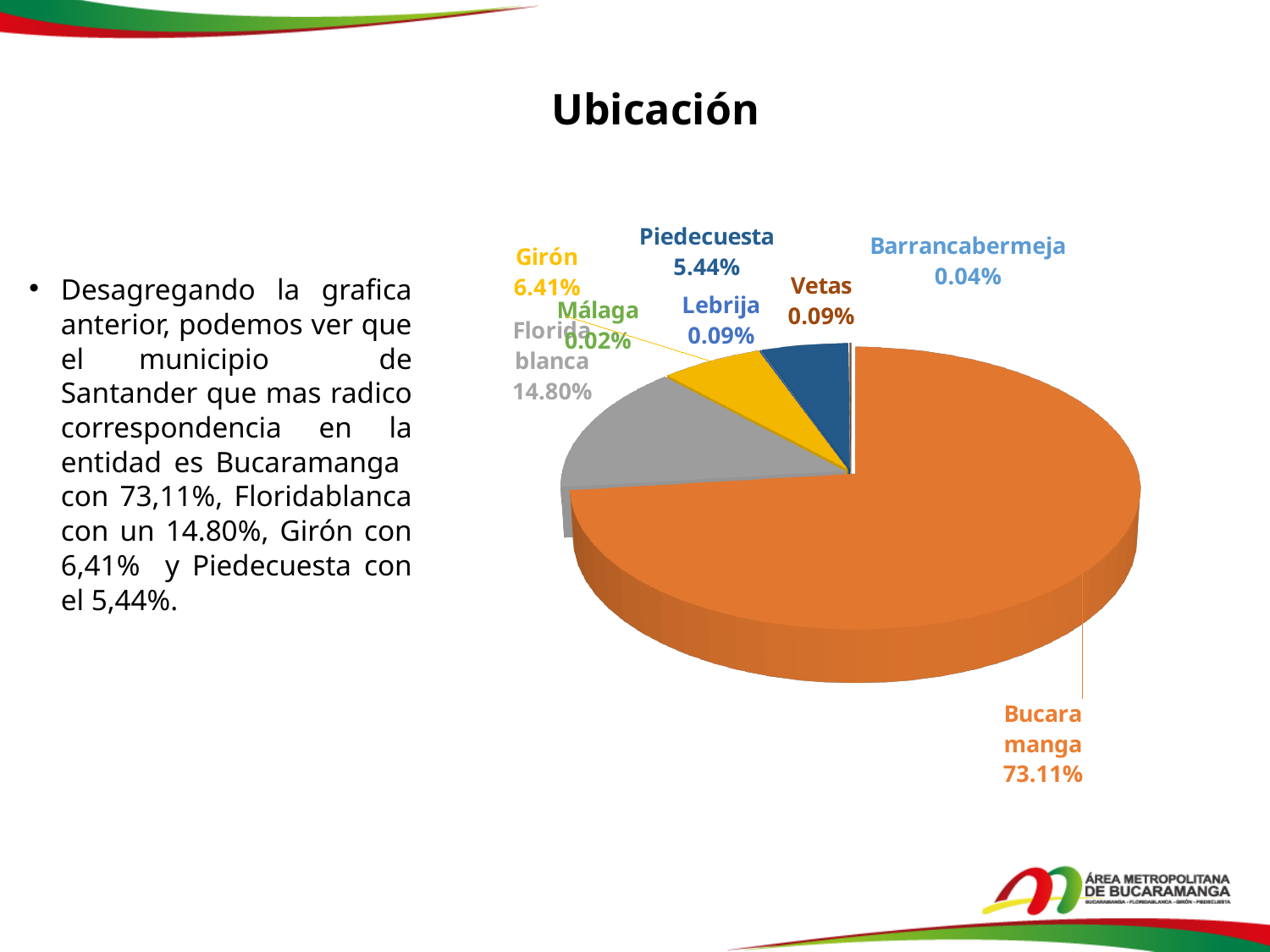
What is the value shown for Málaga? 0.02% Which municipality has the smallest slice of the pie? Málaga What is the value shown for Floridablanca? 14.80% What is the value shown for Barrancabermeja? 0.04% What is the value shown for Piedecuesta? 5.44% Which is larger, the share for Girón or the share for Piedecuesta? Girón How many municipalities are shown in the pie chart? 8 What kind of chart is shown on the slide? Pie chart What is the value shown for Girón? 6.41% Which municipality has the largest slice of the pie? Bucaramanga What is the difference between the shares of Bucaramanga and Floridablanca? 58.31% What share of the pie does Bucaramanga have? 73.11%